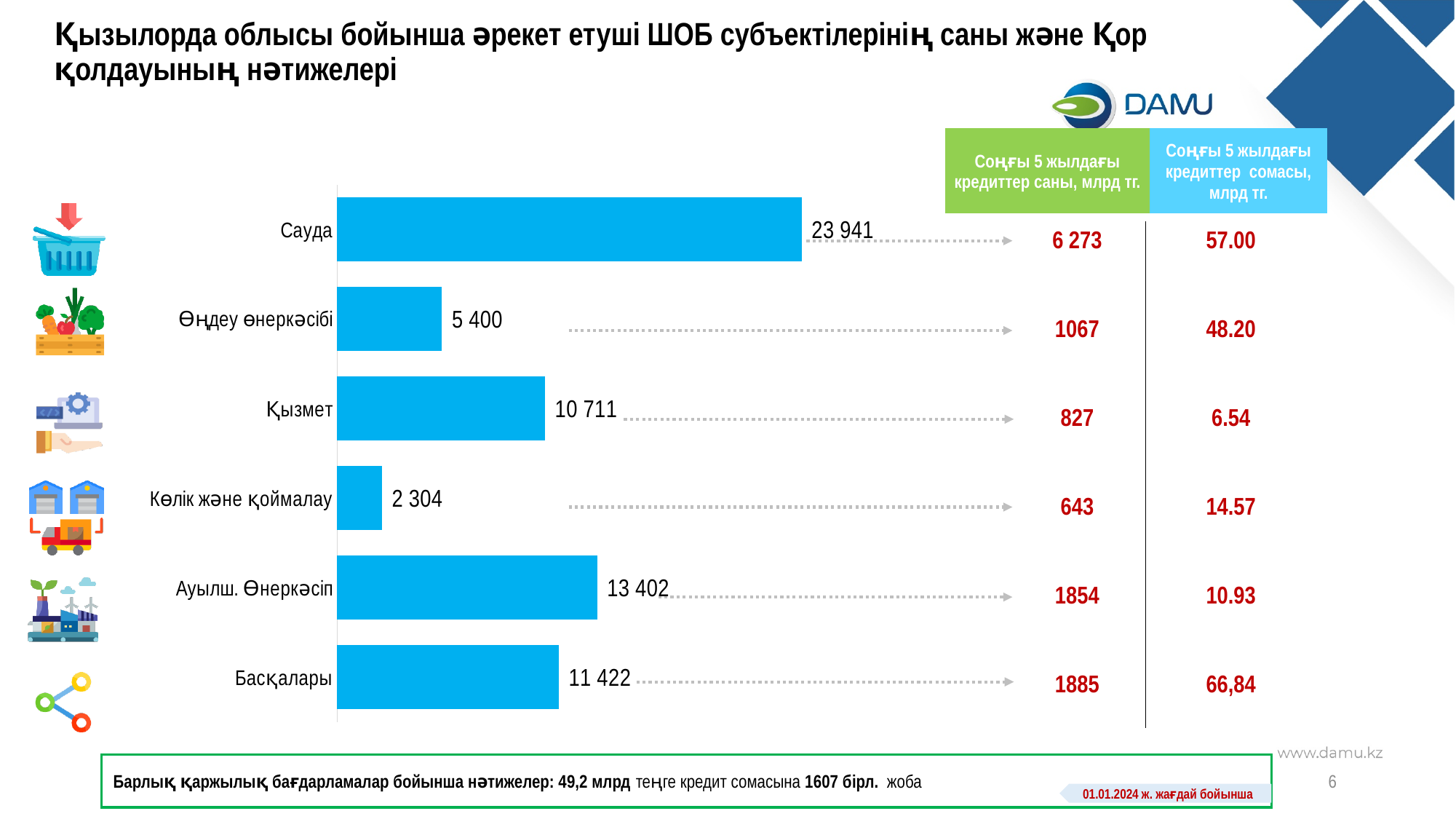
What is the value for Өңдеу өнеркәсібі in the bar chart? 5 400 What is the difference between the values for Ауылш. Өнеркәсіп and Басқалары? 1 980 What is the value for Басқалары in the bar chart? 11 422 What is the value for Сауда in the bar chart? 23 941 What kind of chart is shown on the slide? bar chart What is the value for Көлік және қоймалау in the bar chart? 2 304 Which is larger, the value for Ауылш. Өнеркәсіп or the value for Басқалары? Ауылш. Өнеркәсіп Which category has the highest value in the bar chart? Сауда How many categories are shown in the bar chart? 6 What is the difference between the values for Сауда and Өңдеу өнеркәсібі? 18 541 Which category has the lowest value in the bar chart? Көлік және қоймалау What is the value for Қызмет in the bar chart? 10 711